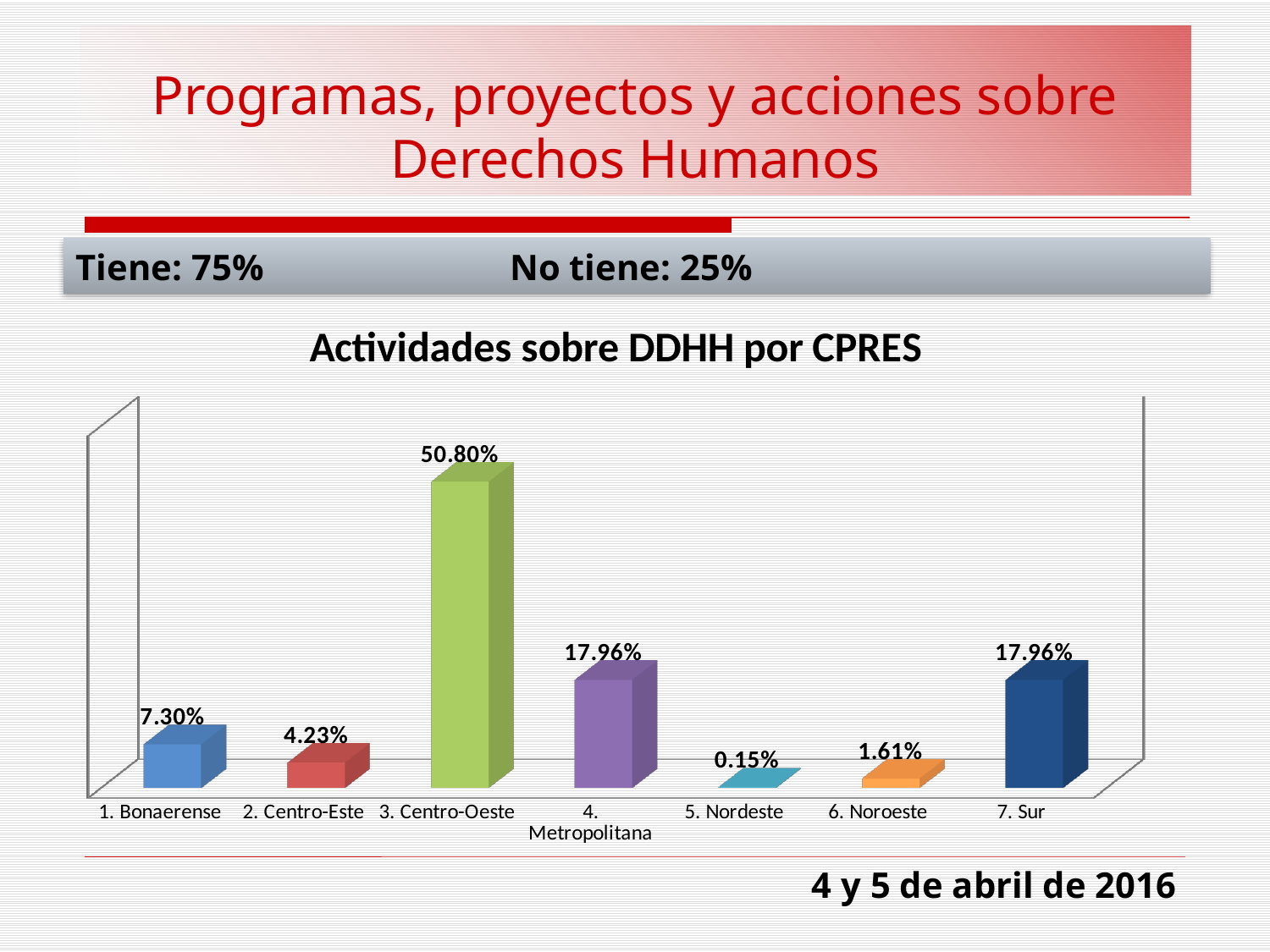
What is the value for 6. Noroeste? 1.61% Which is larger, the value for 1. Bonaerense or the value for 6. Noroeste? 1. Bonaerense What is the value for 3. Centro-Oeste? 50.80% How many categories are shown on the x axis? 7 Which category has the lowest value? 5. Nordeste What is the value for 5. Nordeste? 0.15% What is the difference between the values for 3. Centro-Oeste and 4. Metropolitana? 32.84% What is the value for 1. Bonaerense? 7.30% What is the difference between the values for 1. Bonaerense and 2. Centro-Este? 3.07% Which category has the highest value? 3. Centro-Oeste What kind of chart is shown? bar chart What is the title of the chart? Actividades sobre DDHH por CPRES